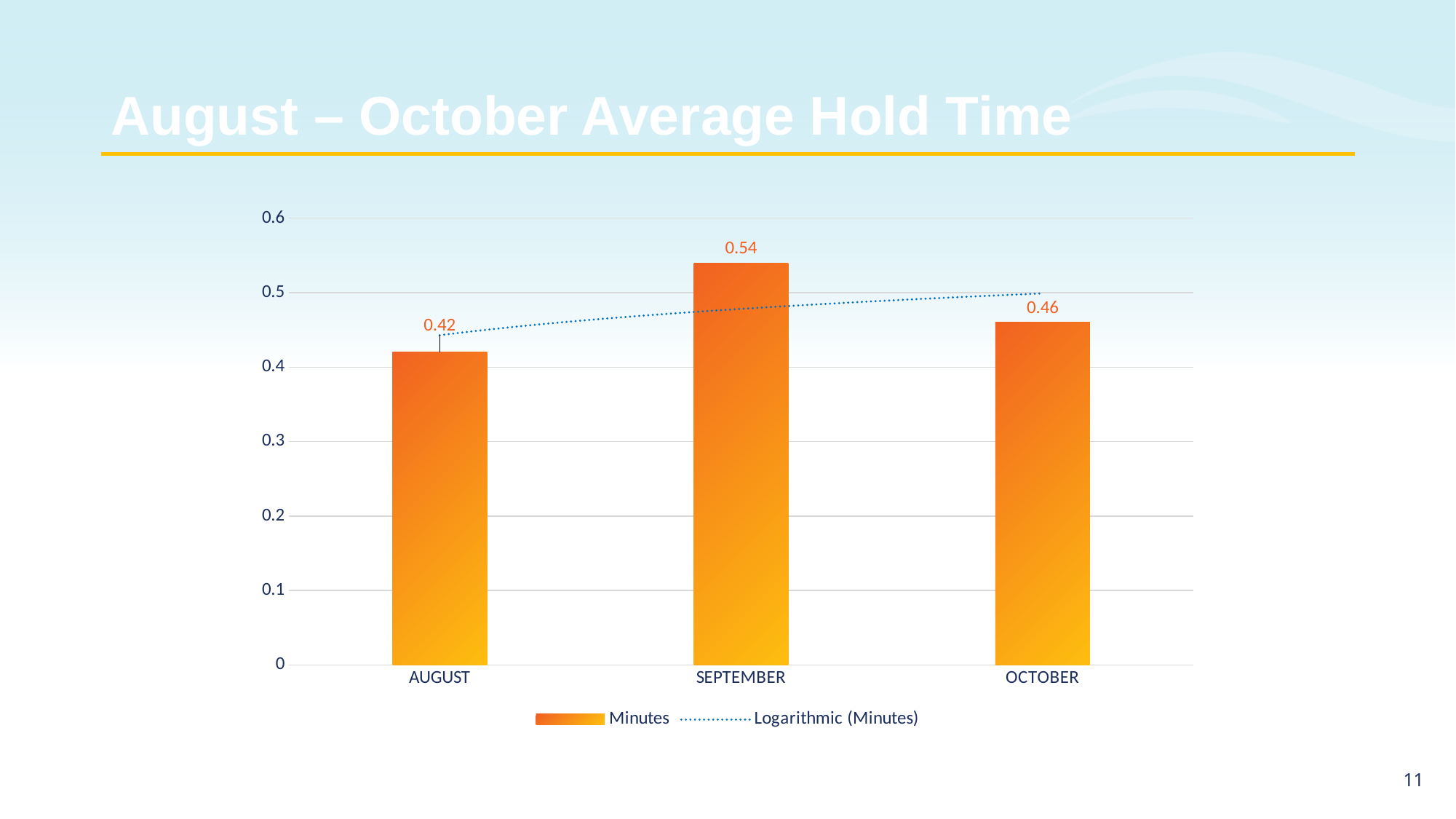
How many entries does the legend list? 2 Which is larger, the value for September or the value for October? September Is the value for August greater or less than 0.5? less What is the value for October? 0.46 Which month has the highest average hold time? September What is the difference between the September and August values? 0.12 What is the difference between the October and August values? 0.04 What is the value for September? 0.54 Which month has the lowest average hold time? August What kind of chart is shown on the slide? Bar chart with a trendline What is the value for August? 0.42 How many months are shown on the x axis? 3